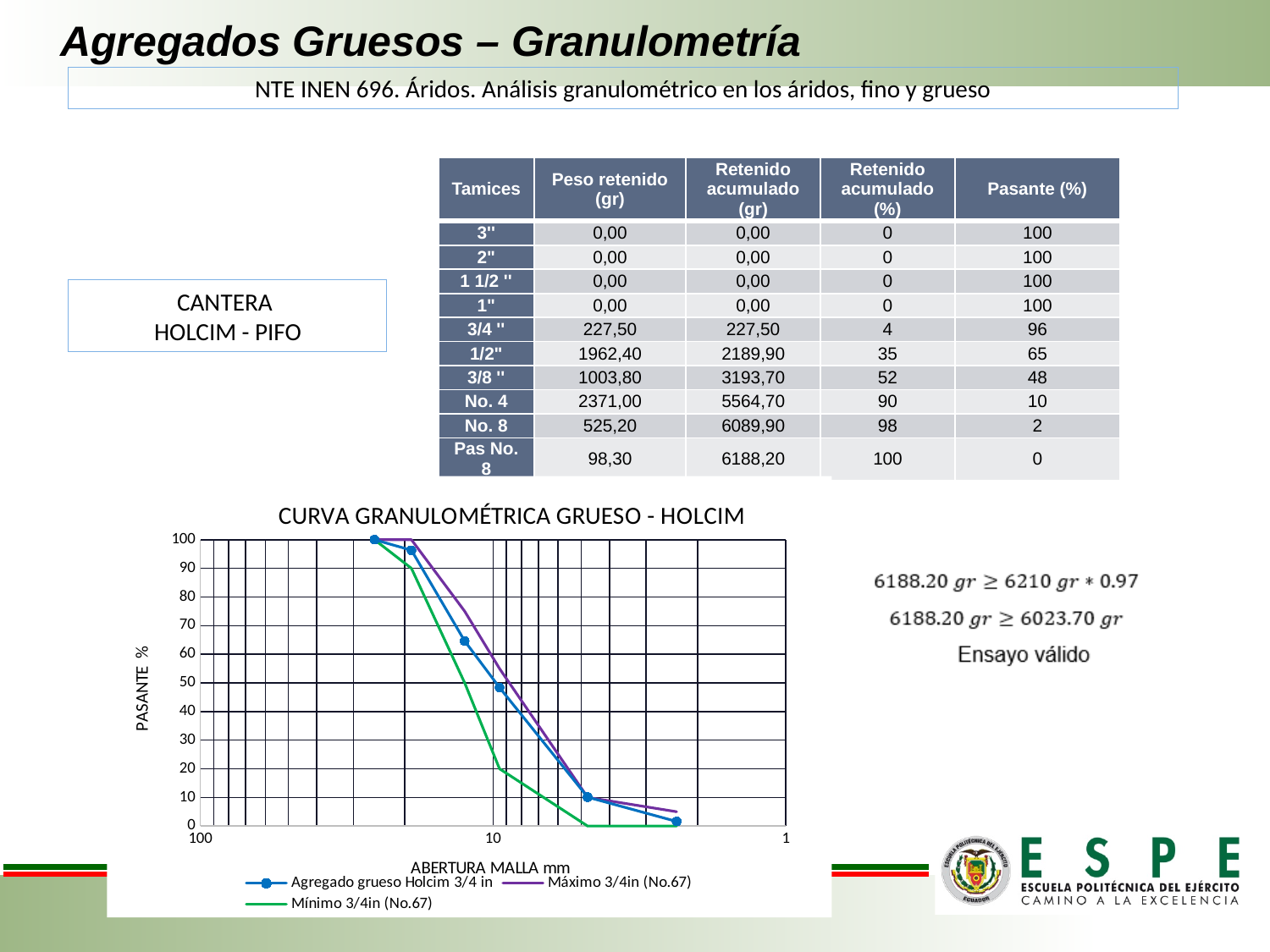
Which series has the lowest values in the middle of the chart? Mínimo 3/4in (No.67) What kind of chart is shown on the slide? line chart Which colour is used for the Mínimo 3/4in (No.67) series? green What is the title of the chart? CURVA GRANULOMÉTRICA GRUESO - HOLCIM At an opening of 10 mm, is the value of the Máximo 3/4in (No.67) series greater or less than 40? greater Is the highest value of the Agregado grueso Holcim 3/4 in series greater or less than 90? greater At an opening of 10 mm, is the value of the Mínimo 3/4in (No.67) series greater or less than 30? less How many series does the legend of the chart list? 3 At an opening of 10 mm, which series is higher, Máximo 3/4in (No.67) or Mínimo 3/4in (No.67)? Máximo 3/4in (No.67) Do the values of the Agregado grueso Holcim 3/4 in series rise or fall moving from left to right along the x axis? fall Which series has the highest values in the middle of the chart? Máximo 3/4in (No.67)